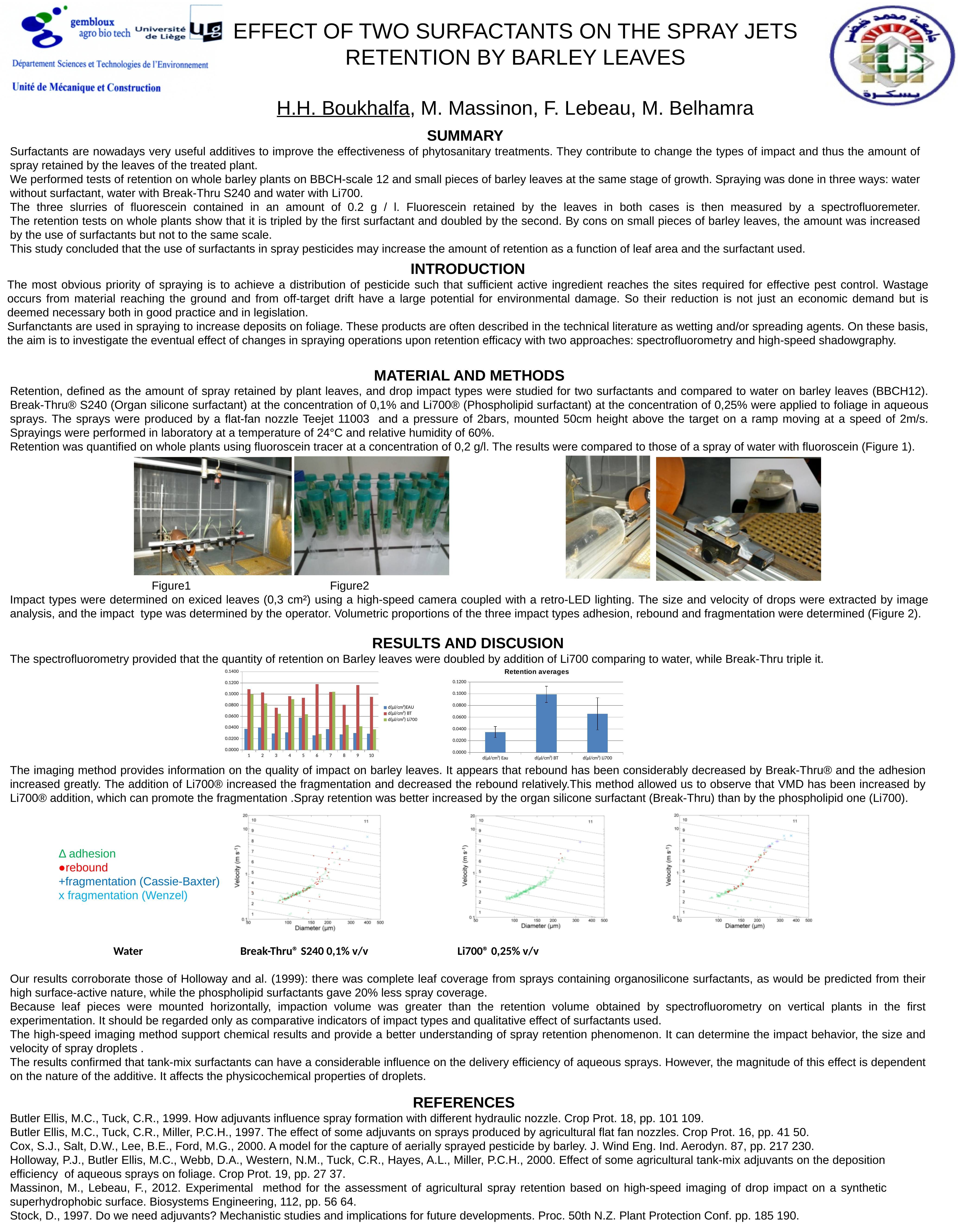
In the left grouped bar chart (next to 'Retention averages'), is the value of the d(µl/cm²)EAU series at category 1 greater or less than 0.0600? less In the 'Retention averages' chart, is the value for d(µl/cm²) Eau greater or less than 0.0600? less In the 'Retention averages' chart, is the value for d(µl/cm²) Li700 greater or less than 0.0400? greater What kind of chart is the 'Retention averages' chart? bar chart How many series does the legend of the left grouped bar chart (next to 'Retention averages') list? 3 In the left grouped bar chart (next to 'Retention averages'), which series has the highest bar at category 6? d(µl/cm²) BT How many bars does the 'Retention averages' chart show? 3 In the 'Retention averages' chart, which category has the lowest value? d(µl/cm²) Eau How many categories are shown on the x axis of the left grouped bar chart (next to 'Retention averages')? 10 In the 'Retention averages' chart, which category has the highest value? d(µl/cm²) BT In the 'Retention averages' chart, which is larger: d(µl/cm²) BT or d(µl/cm²) Li700? d(µl/cm²) BT